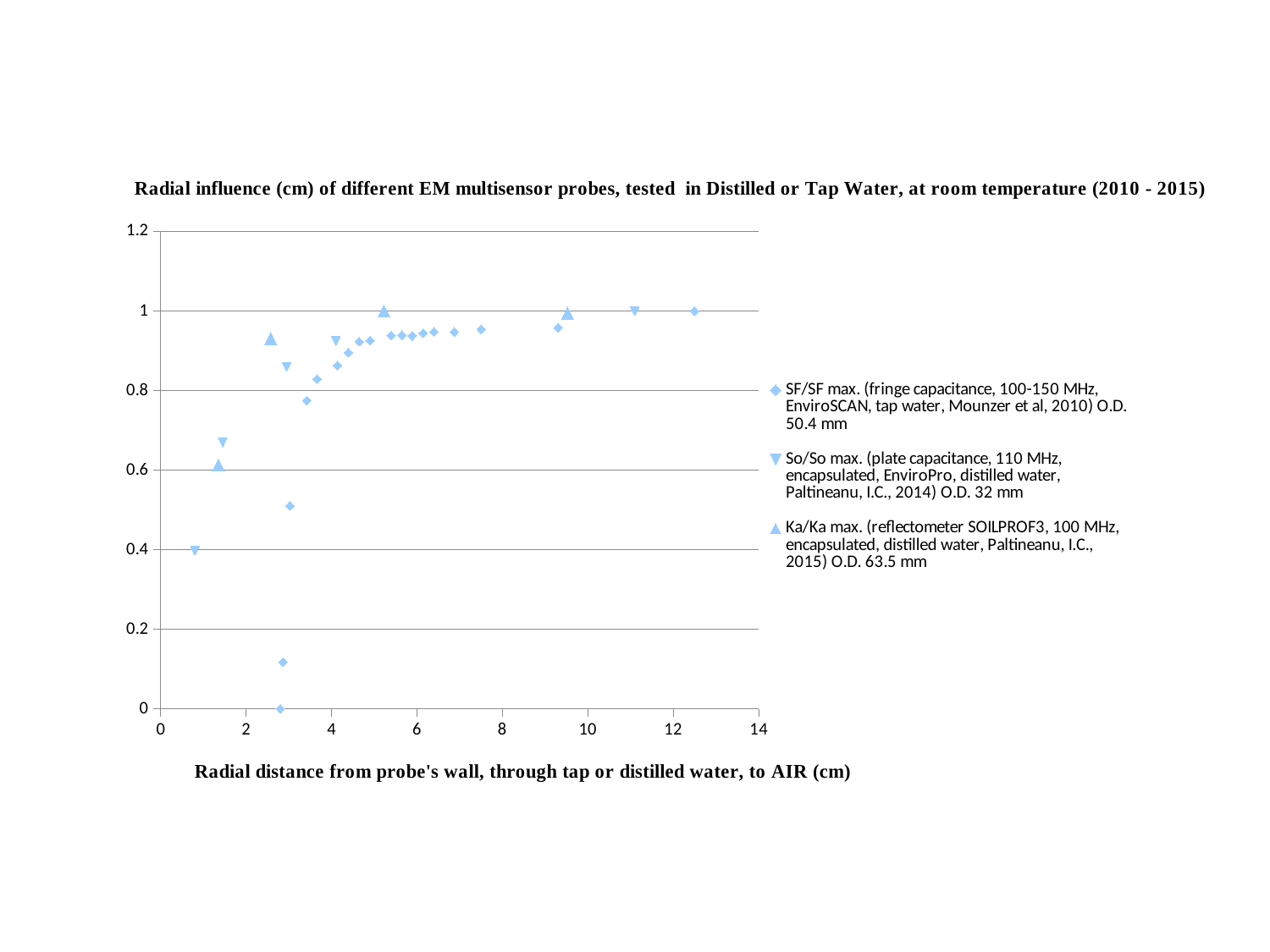
What kind of chart is shown on the slide? scatter chart Do the SF/SF max. values generally rise or fall as the radial distance increases beyond 3 cm? rise What is the maximum value shown on the y axis? 1.2 Is the Ka/Ka max. value at a radial distance of about 2.6 cm greater or less than 0.8? greater What is the label of the x axis? Radial distance from probe's wall, through tap or distilled water, to AIR (cm) Is the SF/SF max. value at the largest radial distance (about 12.5 cm) greater or less than 0.8? greater Is the So/So max. value at the smallest radial distance (about 0.8 cm) greater or less than 0.6? less How many series does the legend list? 3 What is the title of the chart? Radial influence (cm) of different EM multisensor probes, tested in Distilled or Tap Water, at room temperature (2010 - 2015) Which is larger: the So/So max. value at about 0.8 cm or the So/So max. value at about 11 cm? the value at about 11 cm